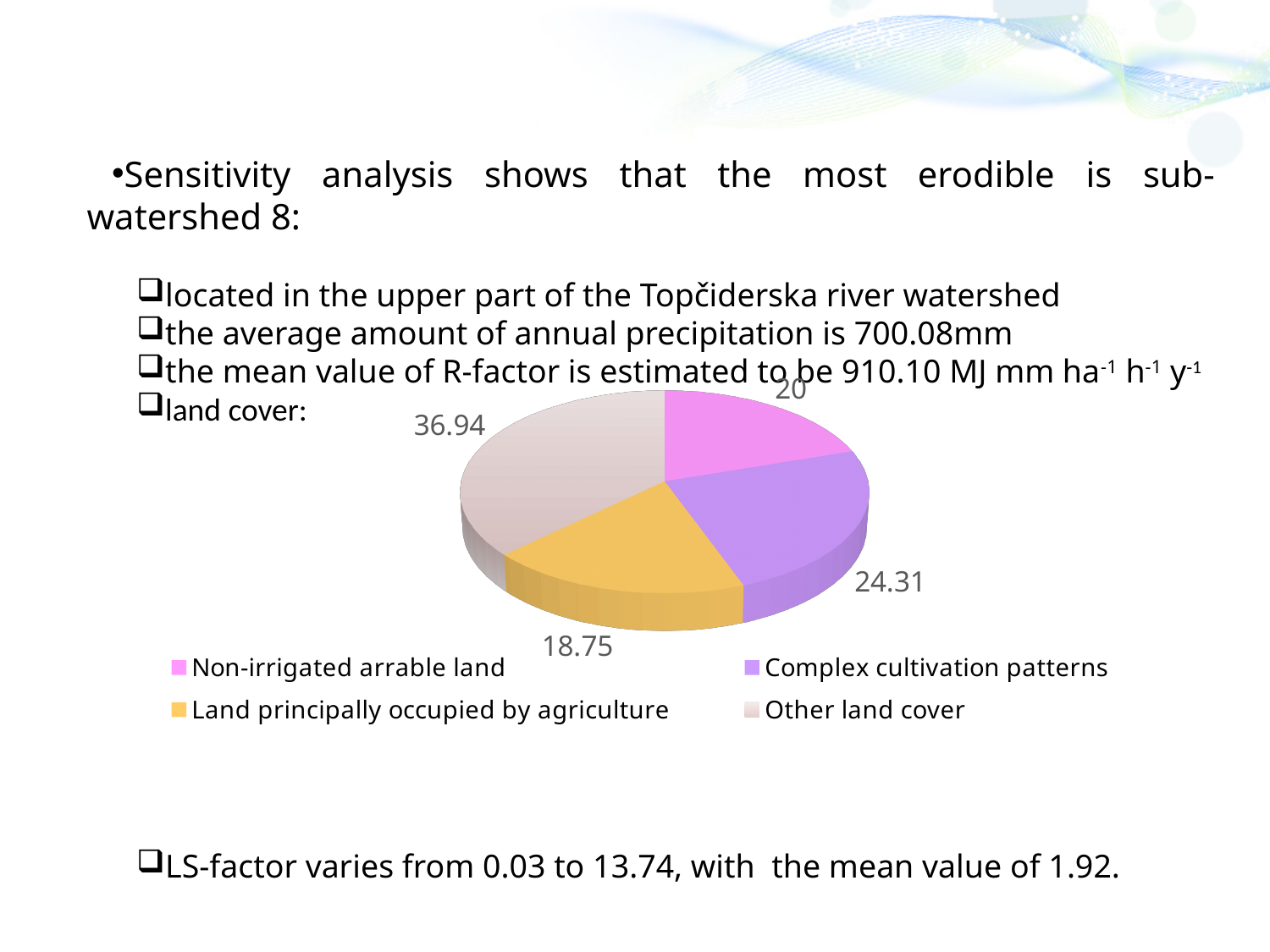
How many entries does the legend of the pie chart list? 4 What is the value for Non-irrigated arrable land in the pie chart? 20 What is the difference between the values for Other land cover and Complex cultivation patterns? 12.63 Which is larger in the pie chart: Non-irrigated arrable land or Complex cultivation patterns? Complex cultivation patterns Which land cover category has the largest slice of the pie chart? Other land cover What is the value for Land principally occupied by agriculture in the pie chart? 18.75 Which colour represents Land principally occupied by agriculture in the pie chart? yellow How many slices does the pie chart have? 4 What is the value for Complex cultivation patterns in the pie chart? 24.31 What kind of chart is shown on the slide? pie chart Which land cover category has the smallest slice of the pie chart? Land principally occupied by agriculture What is the value for Other land cover in the pie chart? 36.94